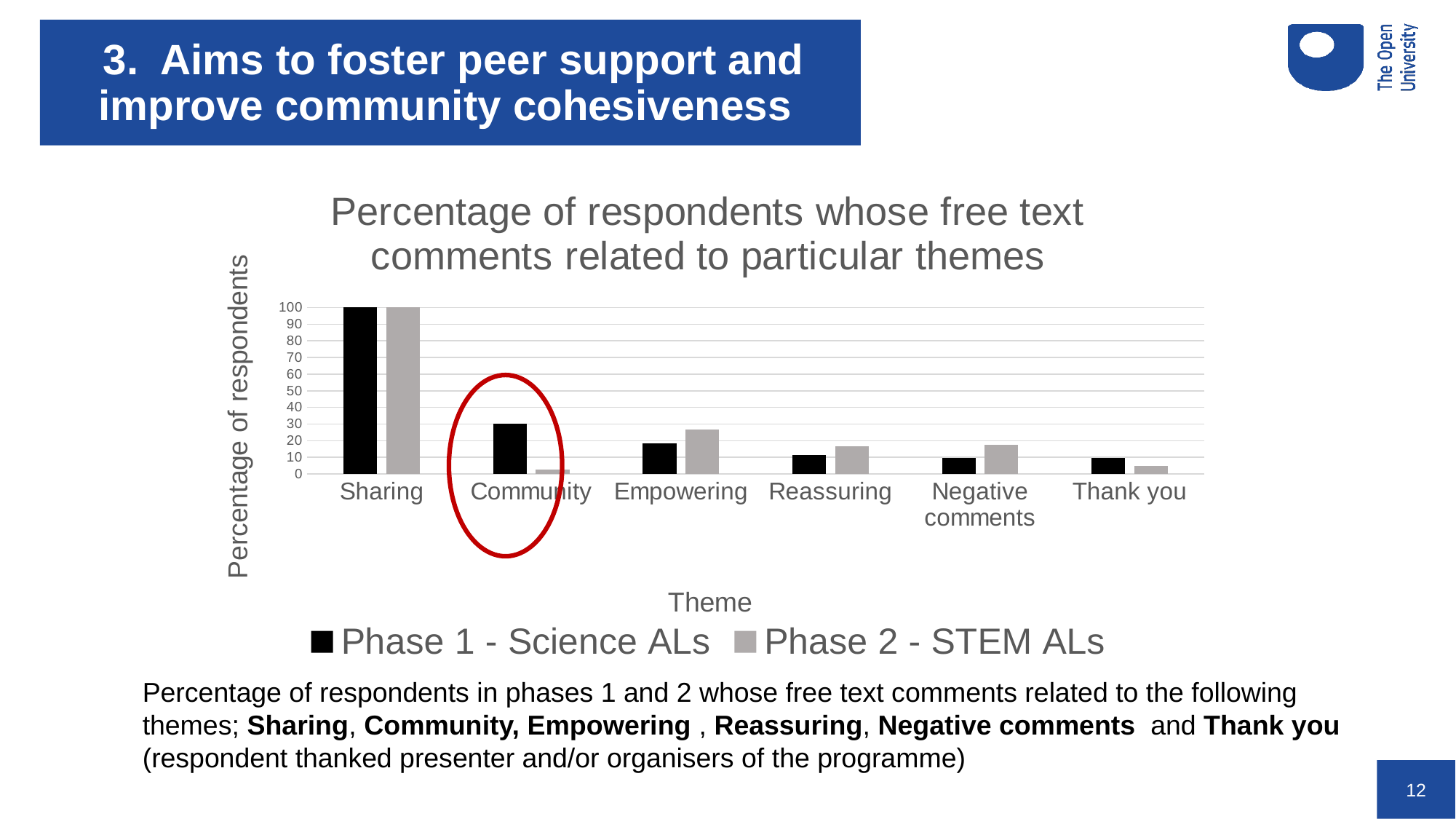
How many series does the chart's legend list? 2 Is the value for Community in the Phase 2 - STEM ALs series greater or less than 10? less What is the value for Sharing in the Phase 1 - Science ALs series? 100 What is the value for Sharing in the Phase 2 - STEM ALs series? 100 For the Empowering theme, which series has the larger value, Phase 1 - Science ALs or Phase 2 - STEM ALs? Phase 2 - STEM ALs Is the value for Empowering in the Phase 2 - STEM ALs series greater or less than 20? greater For the Community theme, which series has the larger value, Phase 1 - Science ALs or Phase 2 - STEM ALs? Phase 1 - Science ALs How many themes are shown on the x axis of the chart? 6 Which theme on the chart is circled in red? Community Which theme has the lowest value for Phase 2 - STEM ALs? Community Which theme has the highest value for Phase 1 - Science ALs? Sharing What kind of chart is shown on the slide? bar chart